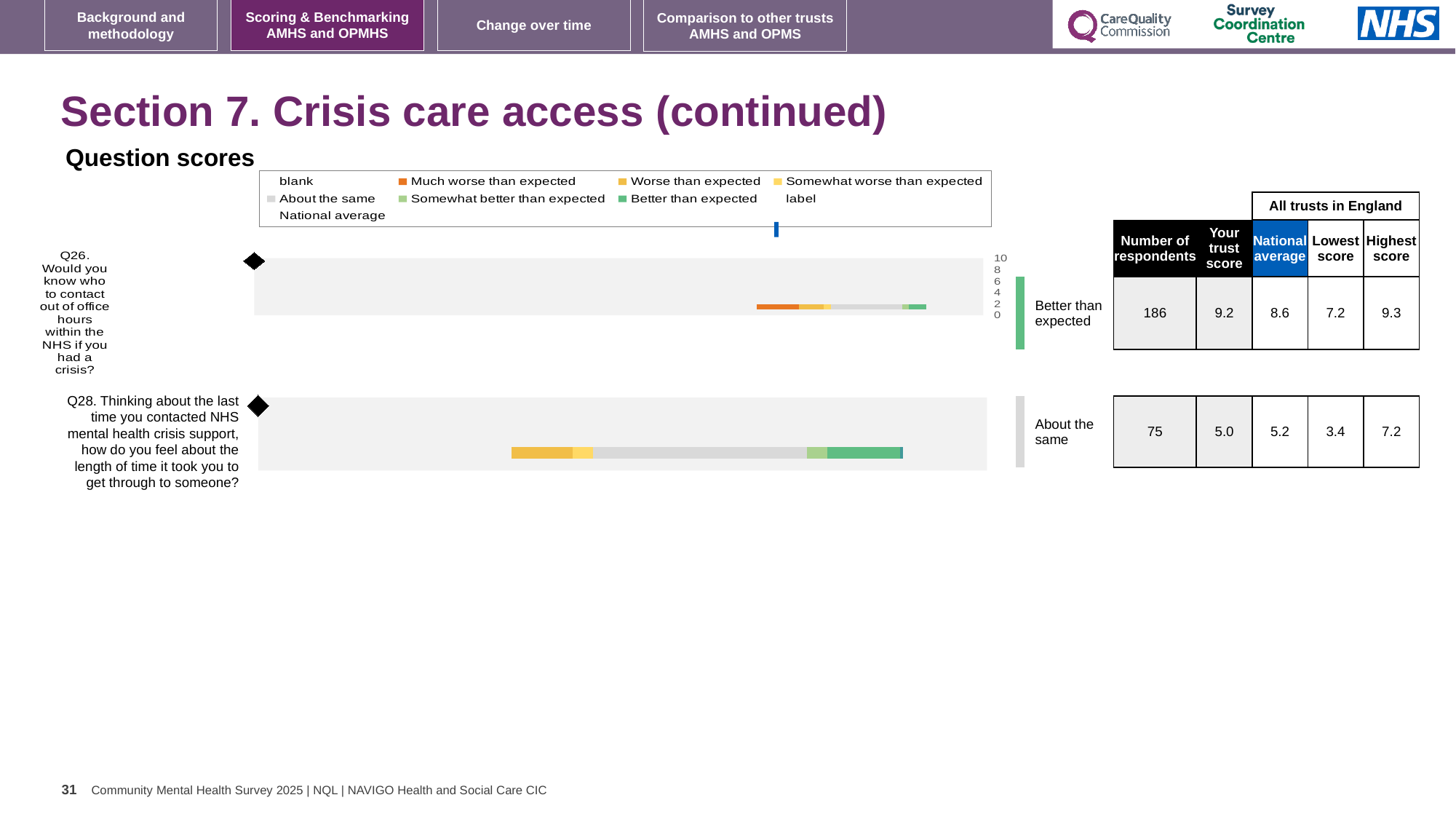
How many questions are plotted in the question scores chart? 2 How many entries does the legend above the question scores chart list? 9 What benchmark category label is shown next to the Q26 bar? Better than expected What is the 'Your trust score' value shown for Q26 (knowing who to contact out of office hours in a crisis)? 9.2 What is the difference between the trust score and the national average for Q26? 0.6 What benchmark category label is shown next to the Q28 bar? About the same What is the national average score shown for Q26? 8.6 Which question has the higher 'Your trust score', Q26 or Q28? Q26 How many respondents are shown for Q28? 75 What is the highest score among all trusts in England shown for Q26? 9.3 What is the 'Your trust score' value shown for Q28 (length of time to get through to crisis support)? 5.0 What type of chart is used to show the question scores for Q26 and Q28? bar chart